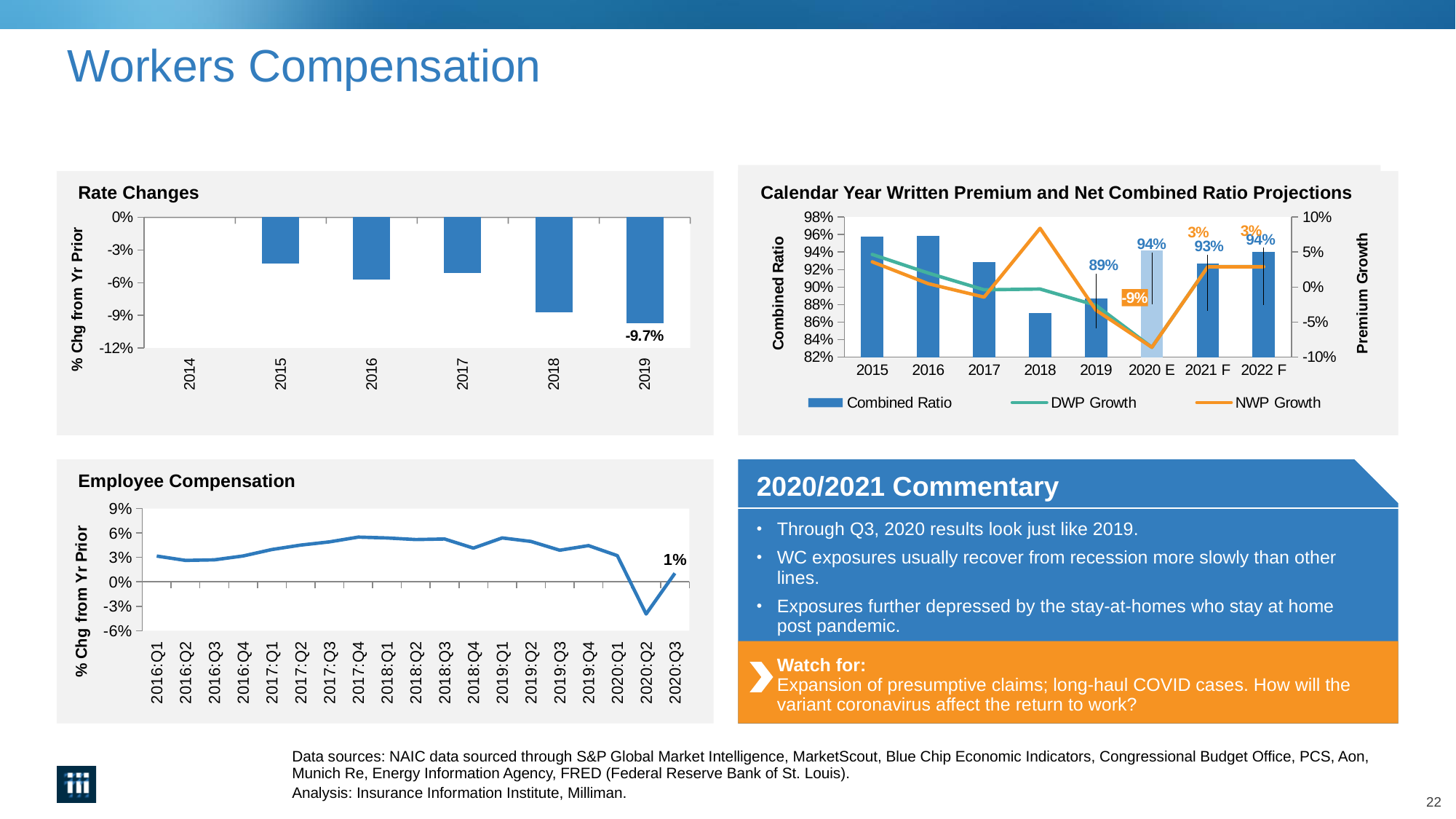
What kind of chart is the Rate Changes chart? bar chart In the Calendar Year Written Premium and Net Combined Ratio Projections chart, what is the NWP Growth value for 2020 E? -9% How many series does the legend of the Calendar Year Written Premium and Net Combined Ratio Projections chart list? 3 In the Rate Changes chart, is the value for 2015 greater or less than -6%? greater In the Calendar Year Written Premium and Net Combined Ratio Projections chart, what is the combined ratio for 2019? 89% In the Rate Changes chart, what is the value for 2019? -9.7% In the Employee Compensation chart, what is the value for 2020:Q3? 1% In the Calendar Year Written Premium and Net Combined Ratio Projections chart, which year has the lowest combined ratio bar? 2018 In the Calendar Year Written Premium and Net Combined Ratio Projections chart, which is larger, the combined ratio for 2021 F or for 2022 F? 2022 F In the Calendar Year Written Premium and Net Combined Ratio Projections chart, what is the difference between the combined ratio for 2020 E and for 2019? 5 percentage points In the Rate Changes chart, is the value for 2018 greater or less than -6%? less In the Employee Compensation chart, which quarter has the lowest value? 2020:Q2